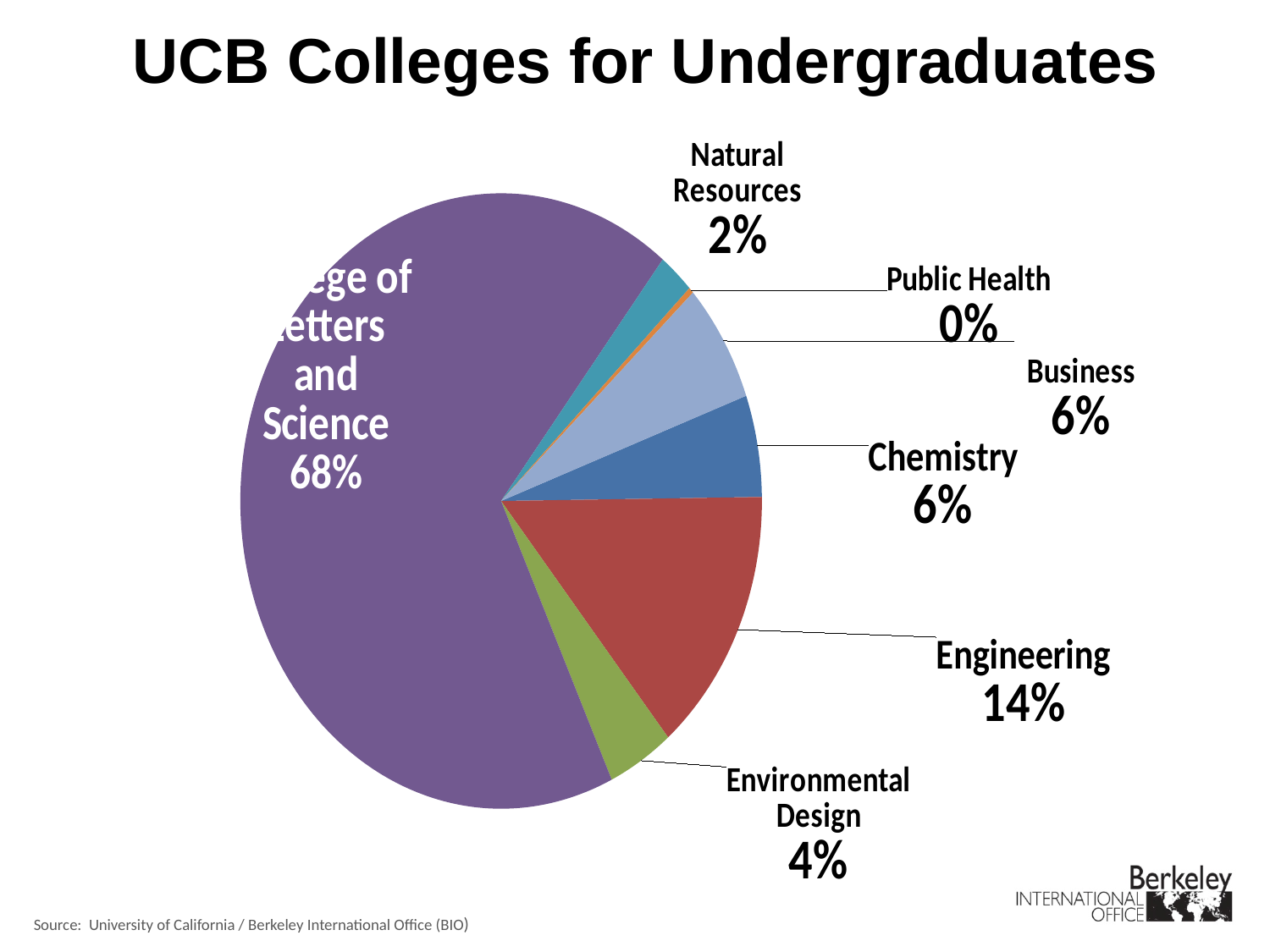
What is the title of the chart on the slide? UCB Colleges for Undergraduates What percentage is shown for Environmental Design? 4% What percentage is shown for Chemistry? 6% Which has a larger share, Engineering or Business? Engineering What share of the pie does Engineering represent? 14% What percentage is shown for Natural Resources? 2% Which college has the largest share of the pie? College of Letters and Science What type of chart is shown on the slide? Pie chart What percentage is shown for Public Health? 0% What is the difference in percentage points between Engineering and Environmental Design? 10 Which college has the smallest share of the pie? Public Health How many colleges are shown as slices in the pie chart? 7